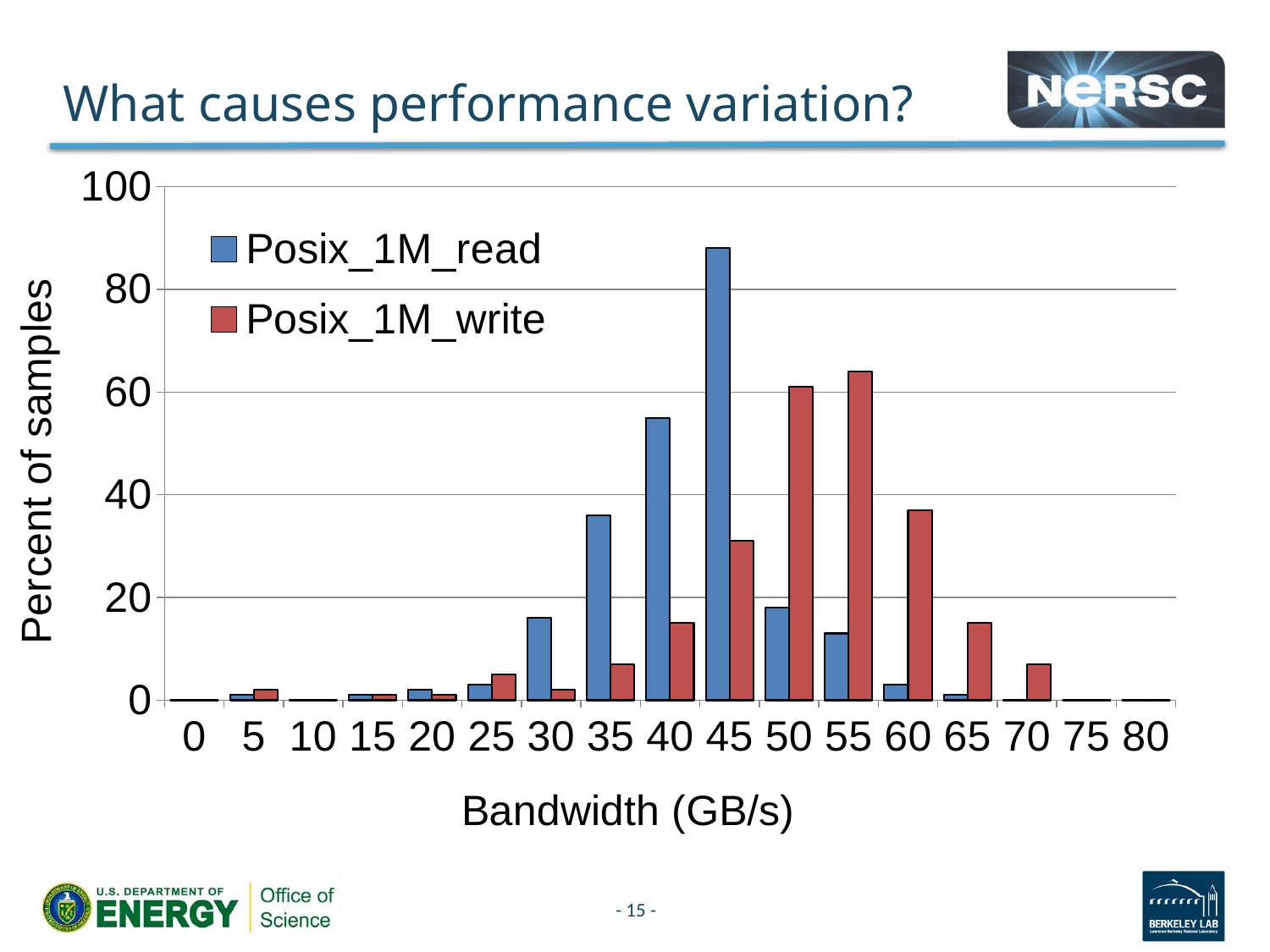
Is the Posix_1M_write value at 55 GB/s greater or less than 60? greater At which bandwidth value is the Posix_1M_read series highest? 45 Is the Posix_1M_write value at 60 GB/s greater or less than 40? less How many bandwidth categories are shown along the x axis? 17 What kind of chart is shown on the slide? bar chart At 55 GB/s, which series has the larger value, Posix_1M_read or Posix_1M_write? Posix_1M_write Is the Posix_1M_read value at 45 GB/s greater or less than 80? greater What is the label of the y axis? Percent of samples How many series does the legend list? 2 At 45 GB/s, which series has the larger value, Posix_1M_read or Posix_1M_write? Posix_1M_read